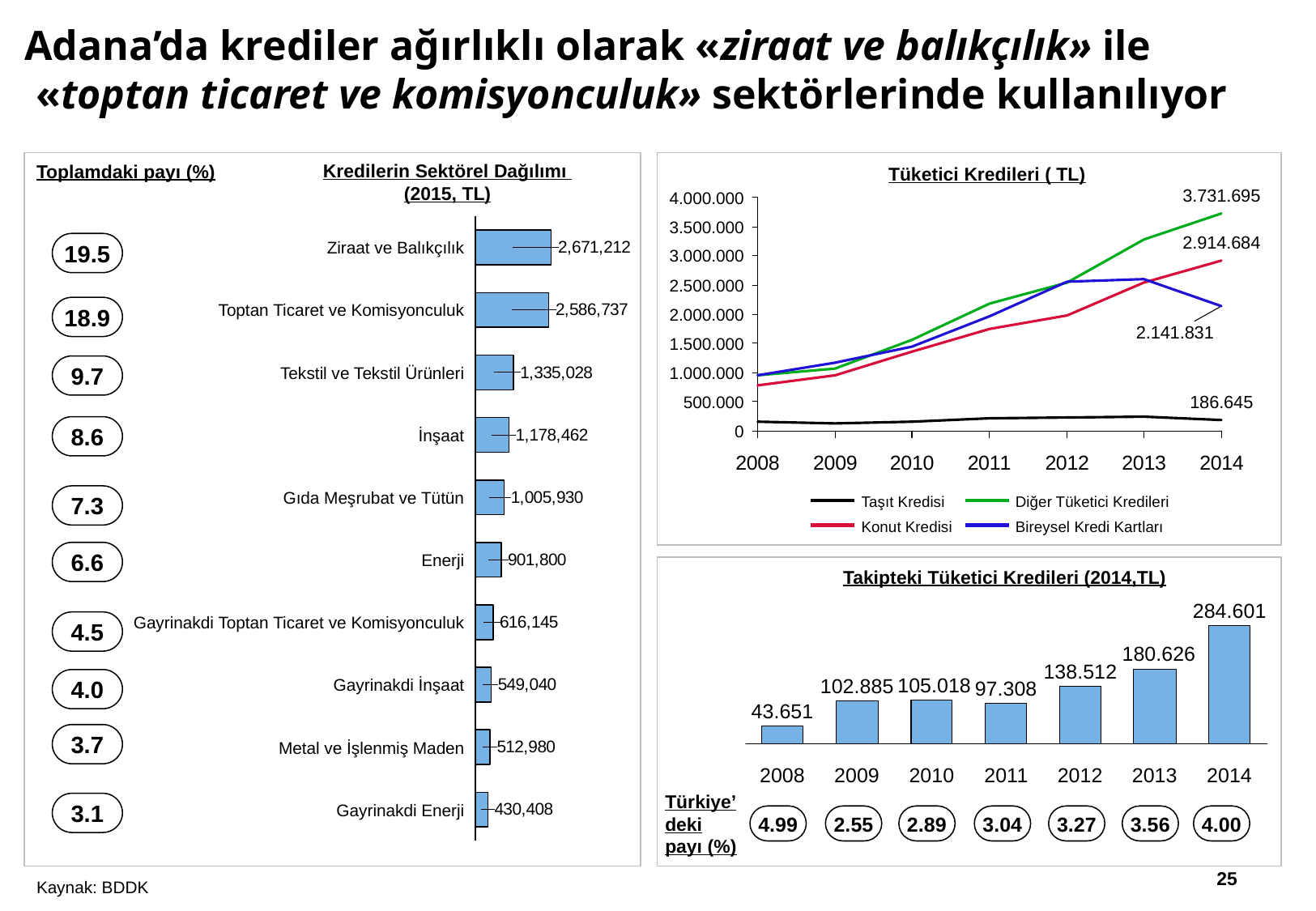
In the 'Kredilerin Sektörel Dağılımı (2015, TL)' chart, which sector has the highest value? Ziraat ve Balıkçılık In the 'Kredilerin Sektörel Dağılımı (2015, TL)' chart, which sector has the lowest value? Gayrinakdi Enerji In the 'Tüketici Kredileri (TL)' chart, what is the 2014 value for Diğer Tüketici Kredileri? 3.731.695 In the 'Kredilerin Sektörel Dağılımı (2015, TL)' chart, what is the value for Tekstil ve Tekstil Ürünleri? 1,335,028 In the 'Takipteki Tüketici Kredileri (2014,TL)' chart, what is the difference between 2014 and 2013? 103.975 In the 'Kredilerin Sektörel Dağılımı (2015, TL)' chart, how many sectors are shown? 10 In the 'Tüketici Kredileri (TL)' chart, what kind of chart is it? line chart In the 'Kredilerin Sektörel Dağılımı (2015, TL)' chart, what is the difference between Ziraat ve Balıkçılık and Toptan Ticaret ve Komisyonculuk? 84,475 In the 'Takipteki Tüketici Kredileri (2014,TL)' chart, which year has the lowest value? 2008 In the 'Takipteki Tüketici Kredileri (2014,TL)' chart, what is the value for 2012? 138.512 In the 'Tüketici Kredileri (TL)' chart, how many series does the legend list? 4 In the 'Tüketici Kredileri (TL)' chart, is the value for Taşıt Kredisi in 2012 greater or less than 500.000? less